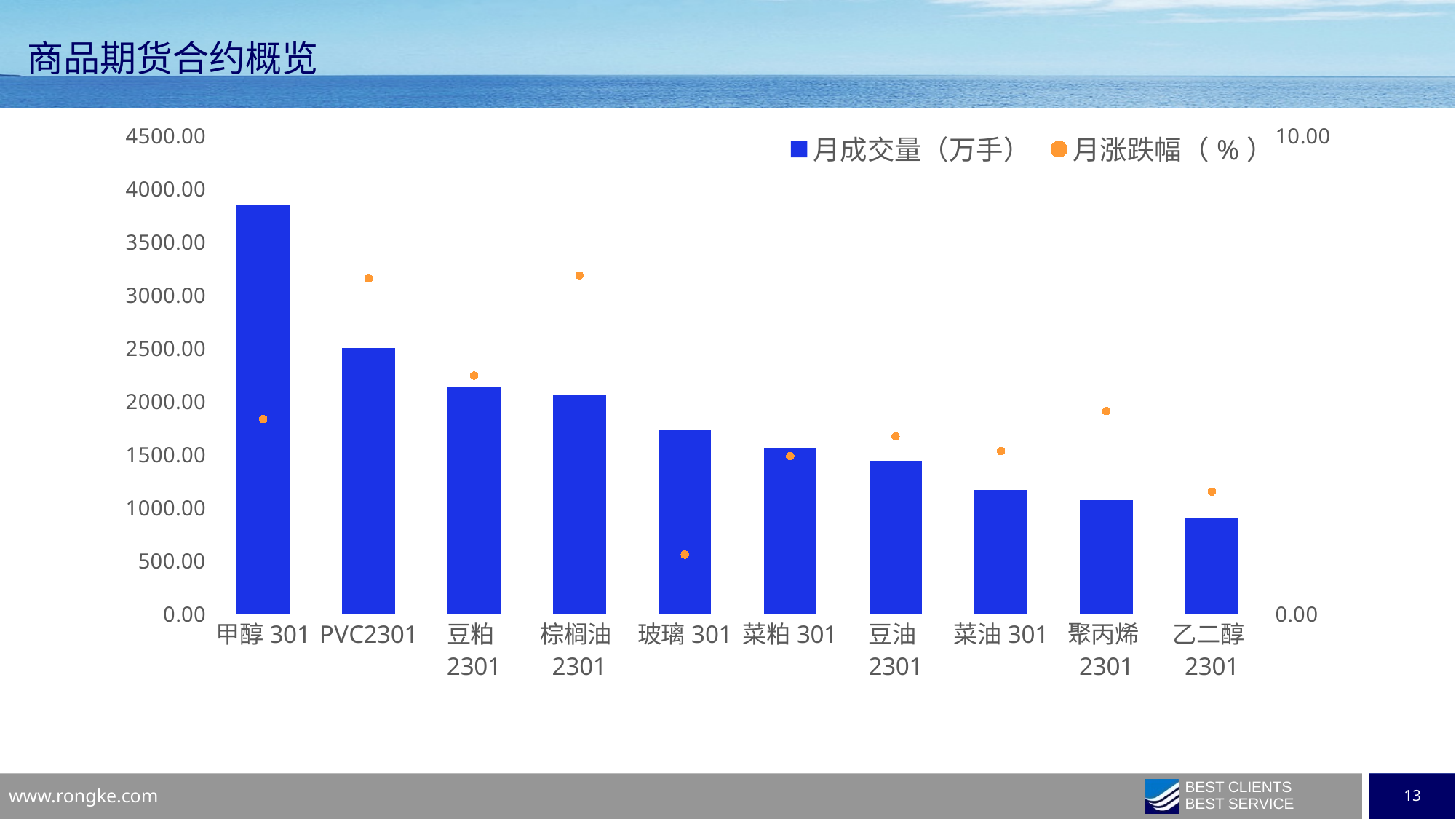
How many series does the legend list? 2 What is the title of the slide? 商品期货合约概览 Which contract has the lowest 月涨跌幅（%）? 玻璃 301 Is the 月成交量（万手） for 甲醇 301 greater or less than 3500? greater Which contract has the highest 月成交量（万手）? 甲醇 301 Do the 月成交量（万手） bars rise or fall from left to right along the x axis? fall Is the 月成交量（万手） for 玻璃 301 greater or less than 1500? greater What kind of chart is shown on the slide? bar chart with a line/dot series (combo chart) Which contract has the lowest 月成交量（万手）? 乙二醇 2301 Which has the larger 月成交量（万手）, 玻璃 301 or 菜粕 301? 玻璃 301 Is the 月成交量（万手） for 乙二醇 2301 greater or less than 1000? less How many contracts (categories) are shown on the x axis? 10